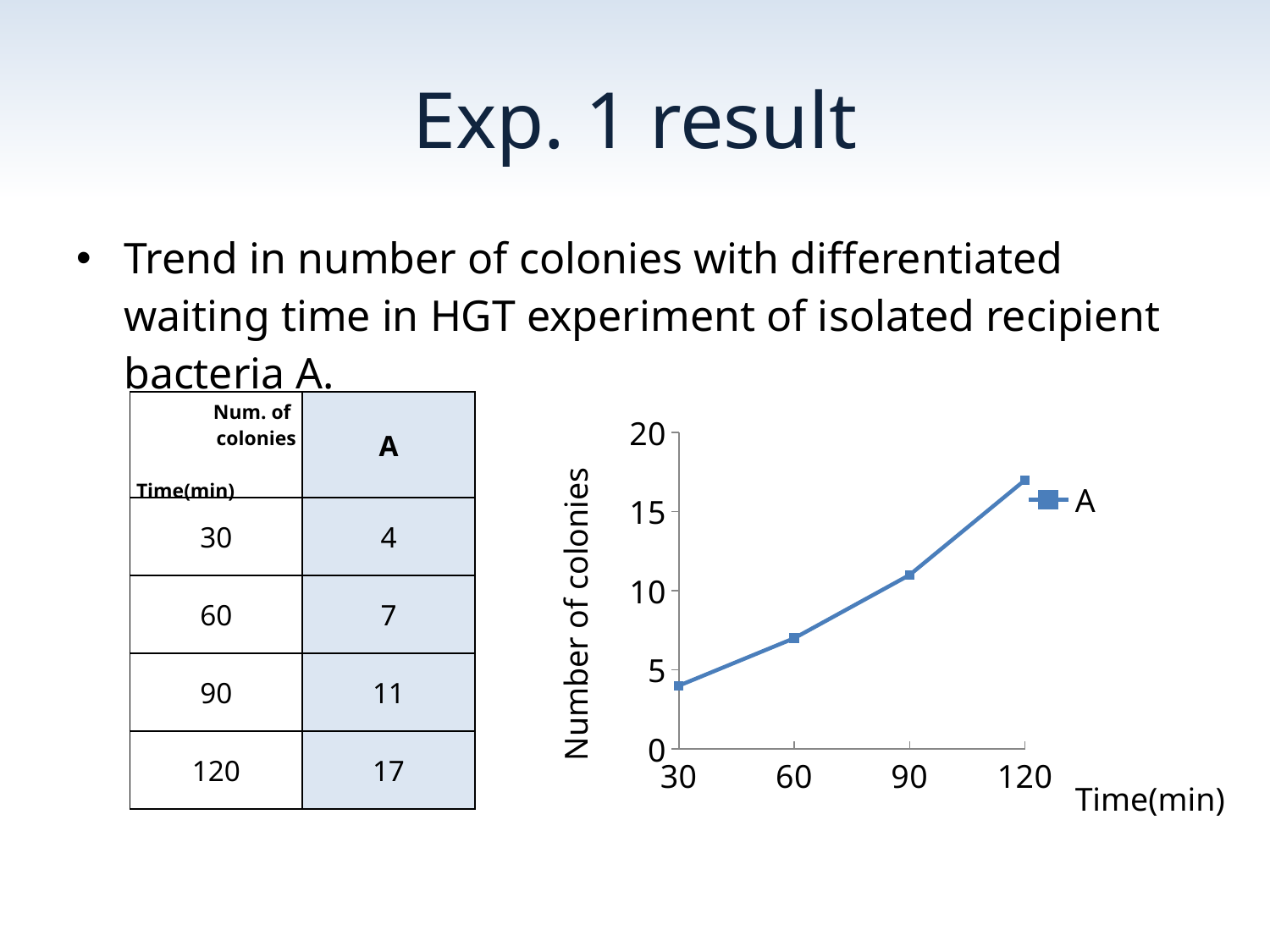
Do the values for series A rise or fall as time increases along the x axis? rise How many data points are plotted on the line for series A? 4 What is the name of the series shown in the chart legend? A At which time is the number of colonies for series A highest? 120 At which time is the number of colonies for series A lowest? 30 What is the difference in number of colonies for series A between 120 min and 30 min? 13 How many series does the chart legend list? 1 What kind of chart is shown on the slide? line chart Is the number of colonies for series A at 90 min greater or less than 10? greater What is the number of colonies for series A at 120 min? 17 What is the number of colonies for series A at 90 min? 11 What is the number of colonies for series A at 30 min? 4